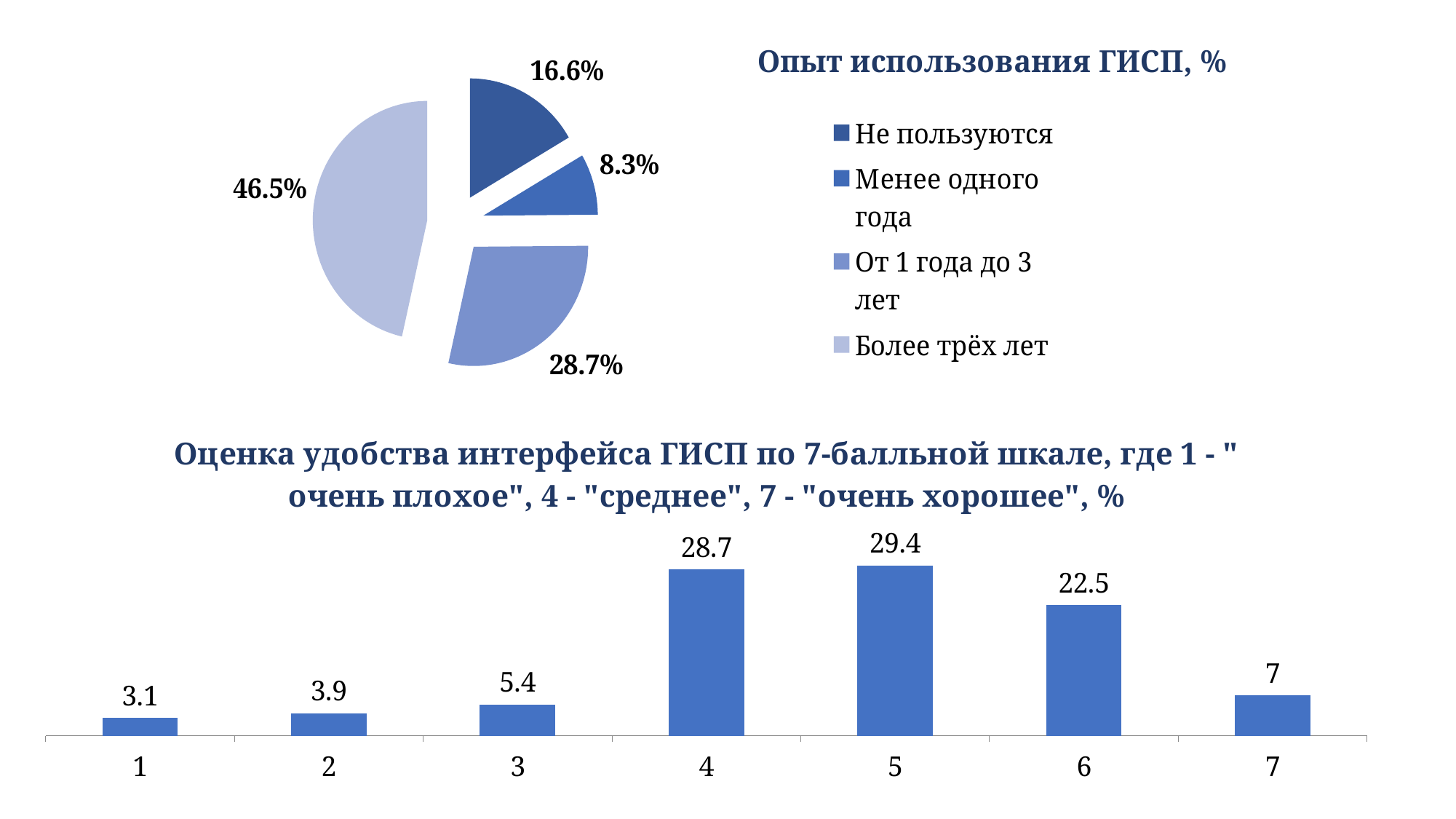
In the bottom bar chart "Оценка удобства интерфейса ГИСП...", how many categories are shown on the x axis? 7 In the pie chart "Опыт использования ГИСП, %", which category has the smallest share? Менее одного года In the pie chart "Опыт использования ГИСП, %", what is the value for "Менее одного года"? 8.3% In the bottom bar chart "Оценка удобства интерфейса ГИСП...", which category has the lowest value? 1 In the bottom bar chart "Оценка удобства интерфейса ГИСП...", which is larger: the value for category 4 or category 6? 4 In the bottom bar chart "Оценка удобства интерфейса ГИСП...", what is the value for category 7? 7 What kind of chart is the chart at the bottom of the slide ("Оценка удобства интерфейса ГИСП...")? bar chart In the pie chart "Опыт использования ГИСП, %", which category has the largest share? Более трёх лет In the bottom bar chart "Оценка удобства интерфейса ГИСП...", what is the value for category 5? 29.4 In the pie chart "Опыт использования ГИСП, %", how many categories does the legend list? 4 In the pie chart "Опыт использования ГИСП, %", what is the value for "Более трёх лет"? 46.5% In the pie chart "Опыт использования ГИСП, %", what is the difference between "От 1 года до 3 лет" and "Не пользуются"? 12.1%